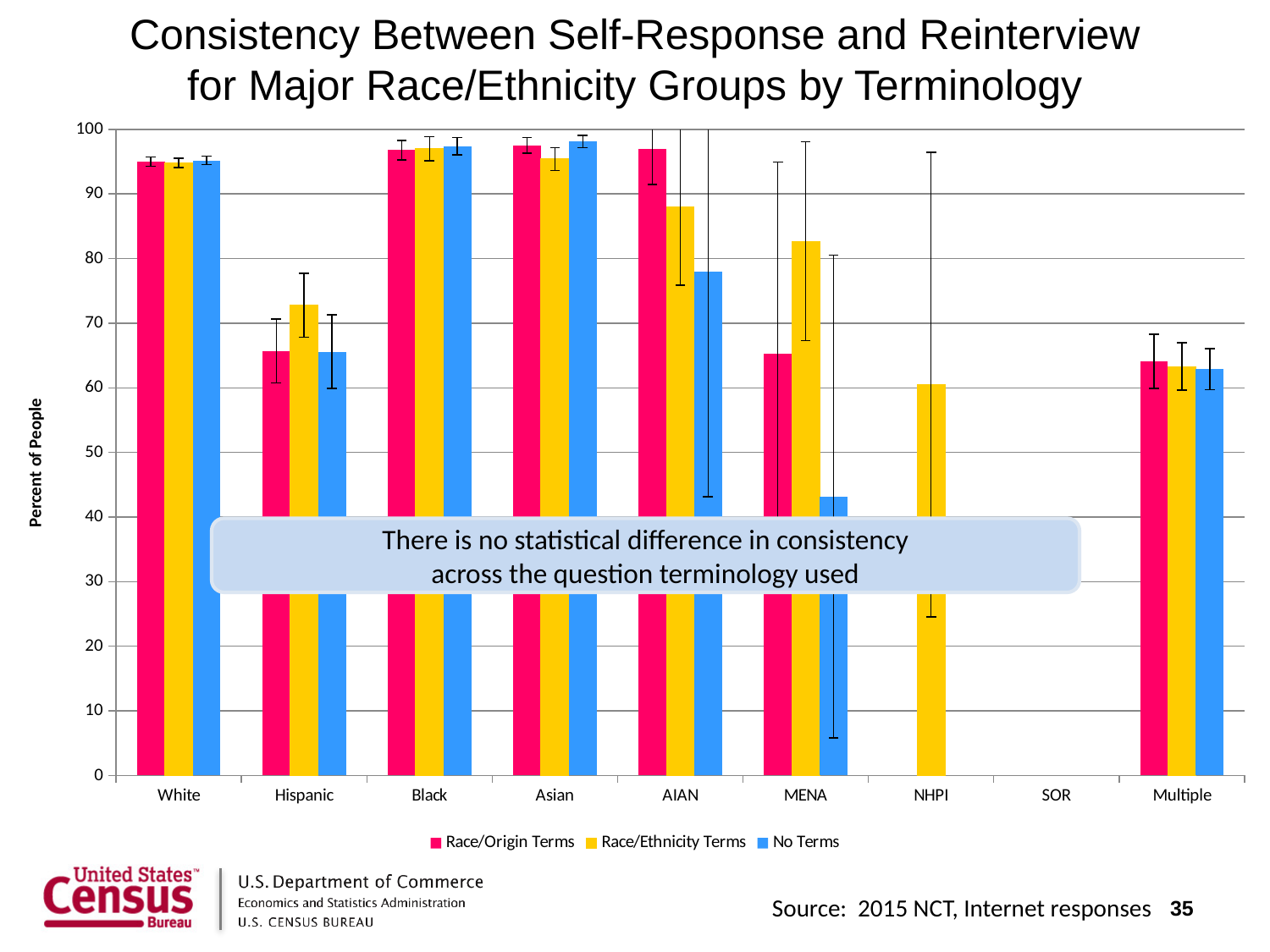
For Hispanic, which is larger: the Race/Origin Terms value or the Race/Ethnicity Terms value? Race/Ethnicity Terms What is the label on the y axis? Percent of People Is the value for Hispanic under Race/Origin Terms greater or less than 60? greater Is the value for AIAN under Race/Ethnicity Terms greater or less than 90? less For AIAN, which series has the highest value? Race/Origin Terms Is the value for MENA under No Terms greater or less than 50? less How many race/ethnicity groups are shown on the x axis? 9 What kind of chart is shown on the slide? Bar chart For MENA, which is larger: the Race/Ethnicity Terms value or the No Terms value? Race/Ethnicity Terms How many series does the legend list? 3 Which colour represents the No Terms series? Blue